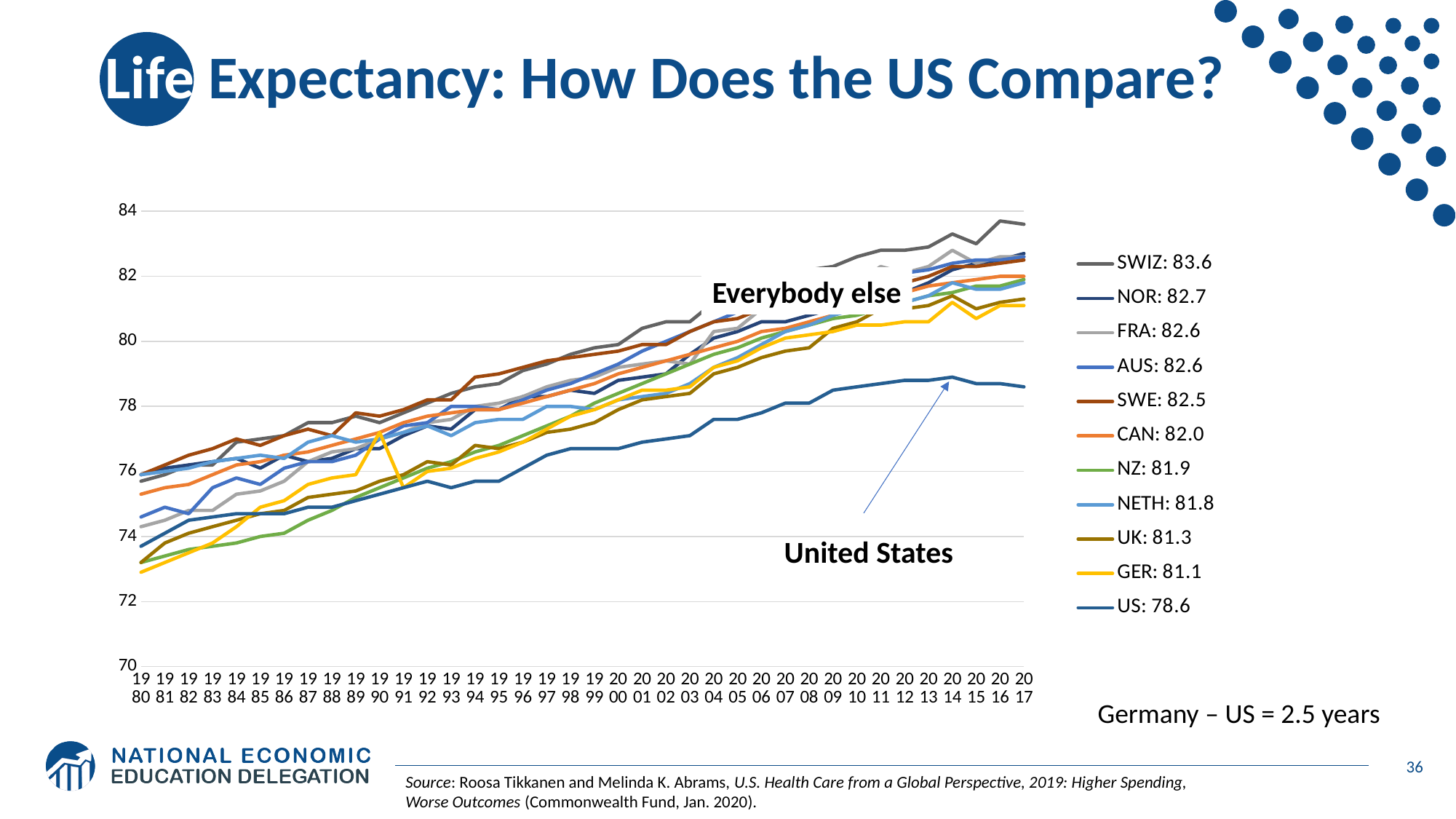
What value is shown for US in the legend? 78.6 Which country has the lowest value in the legend? US What is the first year shown on the x axis? 1980 What value is shown for SWIZ in the legend? 83.6 Does the US line rise or fall from 1980 to 2017? rise What is the difference between the legend values for GER and US? 2.5 Is the value for the US line in 2017 greater or less than 80? less What is the difference between the legend values for SWIZ and US? 5.0 How many series does the legend list? 11 Which country has the highest value in the legend? SWIZ What kind of chart is shown on the slide? line chart Which has the larger legend value, NOR or CAN? NOR